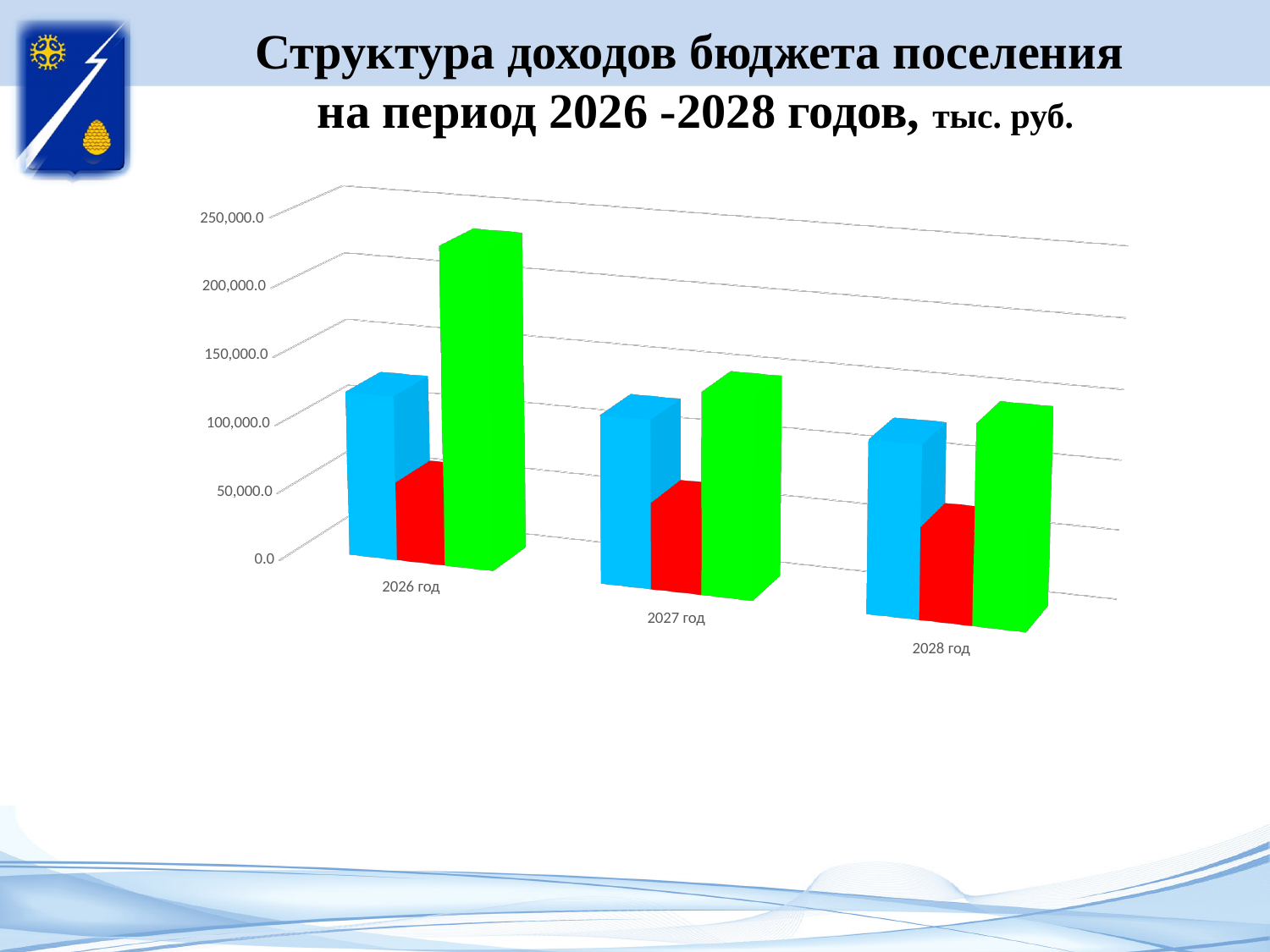
Is the value of the green bar for 2026 год greater or less than 200,000.0? greater Do the green bars rise or fall from 2026 год to 2028 год? fall Is the value of the blue bar for 2026 год greater or less than 100,000.0? greater Is the value of the red bar for 2026 год greater or less than 100,000.0? less What kind of chart is shown on the slide? bar chart Which bar is the shortest in the 2027 год group? the red bar In 2027 год, which is larger: the blue bar or the red bar? the blue bar How many bars are plotted for each year category? 3 How many year categories are shown on the x axis? 3 Which bar is the tallest in the 2026 год group? the green bar What unit of measurement is stated in the chart title? тыс. руб.